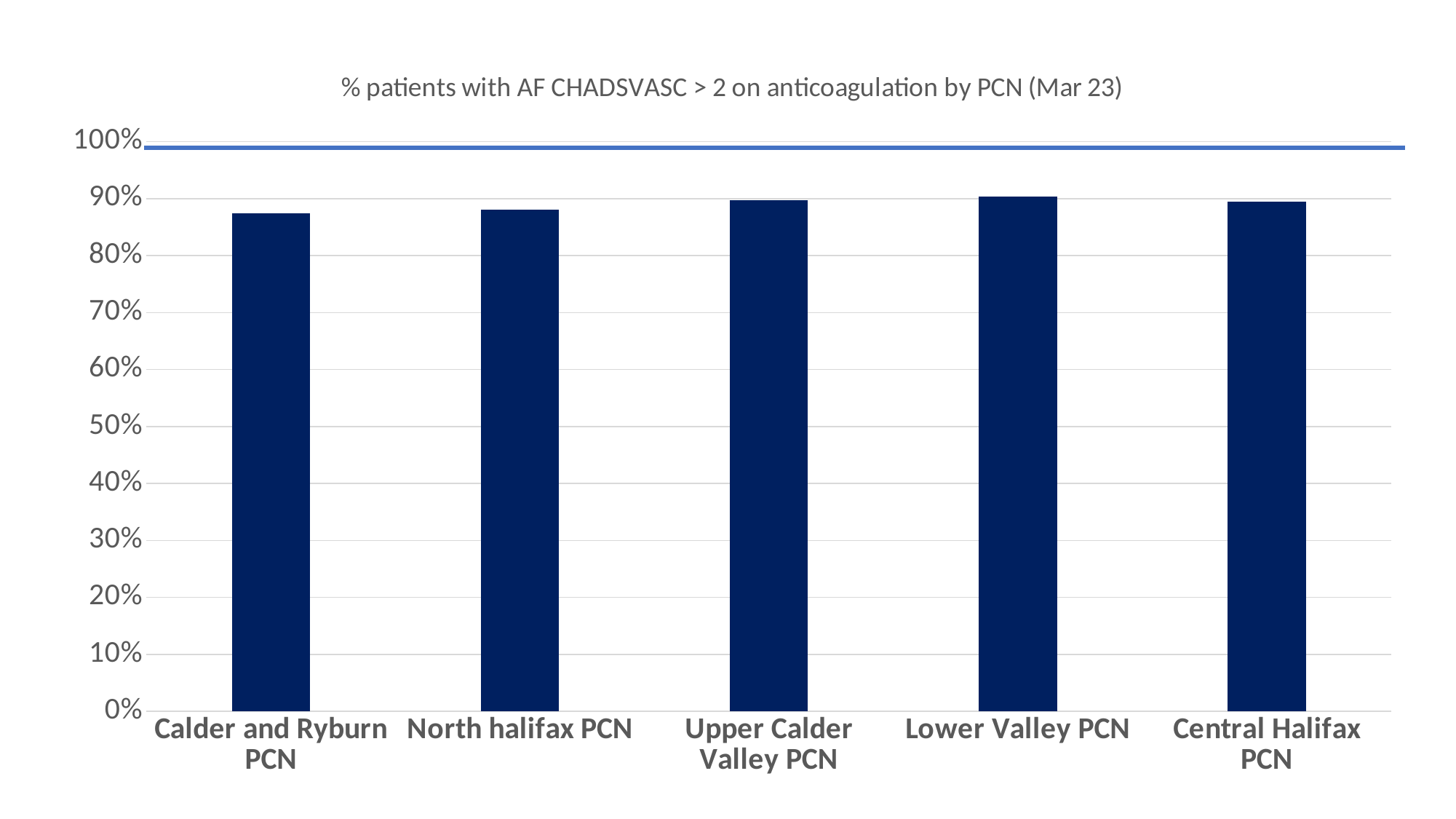
How many PCNs are shown on the x axis of the chart? 5 What is the highest value shown on the y axis of the chart? 100% Is the value for Calder and Ryburn PCN greater or less than 80%? greater Is the value for Calder and Ryburn PCN greater or less than 90%? less What is the title of the chart? % patients with AF CHADSVASC > 2 on anticoagulation by PCN (Mar 23) Is the value for Lower Valley PCN greater or less than 80%? greater What kind of chart is shown on the slide? bar chart Which has the larger value, Calder and Ryburn PCN or Upper Calder Valley PCN? Upper Calder Valley PCN Which has the larger value, Calder and Ryburn PCN or Lower Valley PCN? Lower Valley PCN